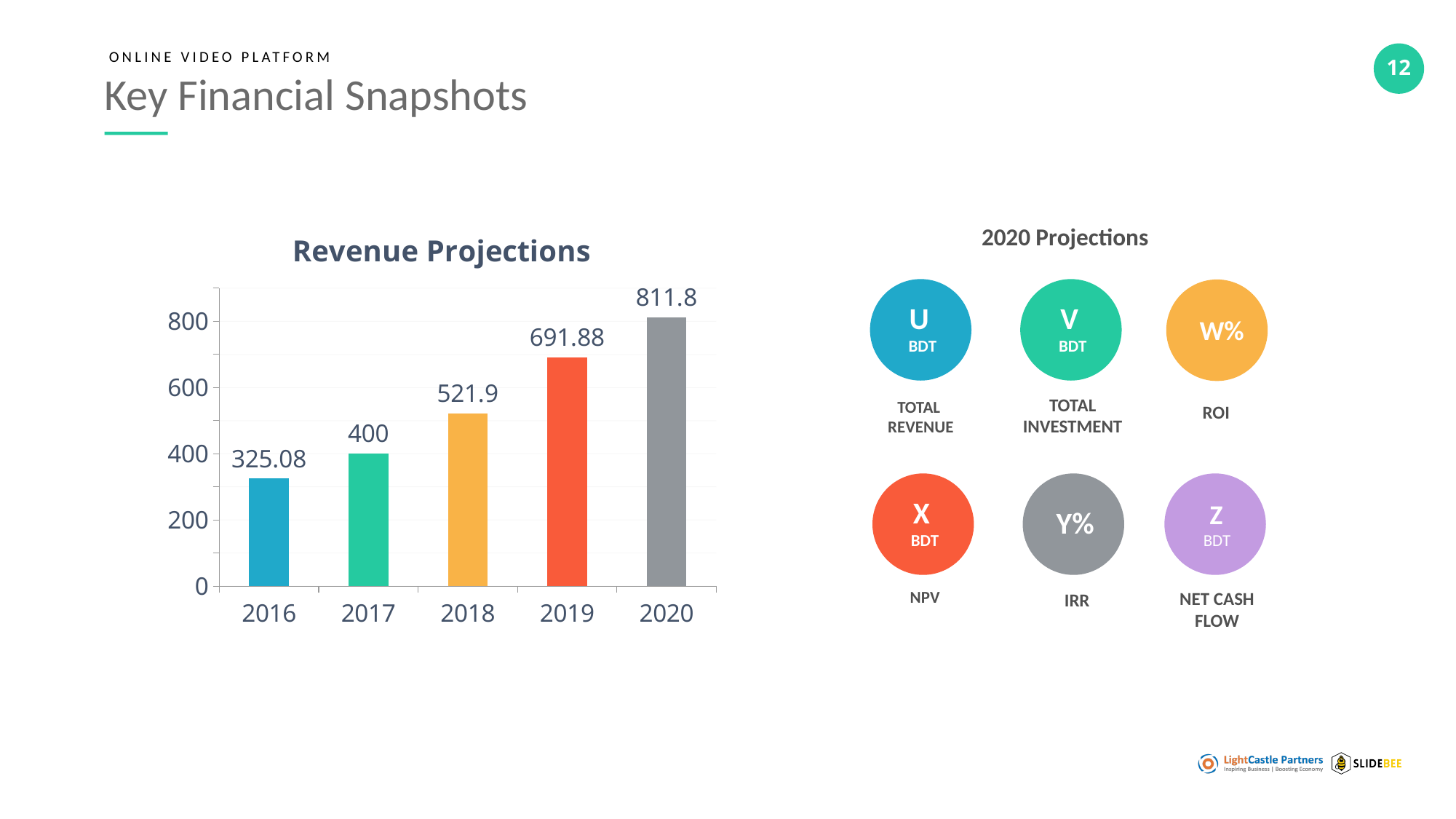
What is the difference between the 2020 and 2019 values in the Revenue Projections chart? 119.92 What is the value for 2020 in the Revenue Projections chart? 811.8 What kind of chart is the Revenue Projections chart? bar chart Is the value for 2019 in the Revenue Projections chart greater or less than 600? greater What is the difference between the 2017 and 2016 values in the Revenue Projections chart? 74.92 Which is larger in the Revenue Projections chart, the value for 2018 or the value for 2019? 2019 How many years are shown in the Revenue Projections chart? 5 Which year has the lowest value in the Revenue Projections chart? 2016 Which year has the highest value in the Revenue Projections chart? 2020 What is the value for 2018 in the Revenue Projections chart? 521.9 Do the values in the Revenue Projections chart rise or fall from 2016 to 2020? rise What is the value for 2016 in the Revenue Projections chart? 325.08